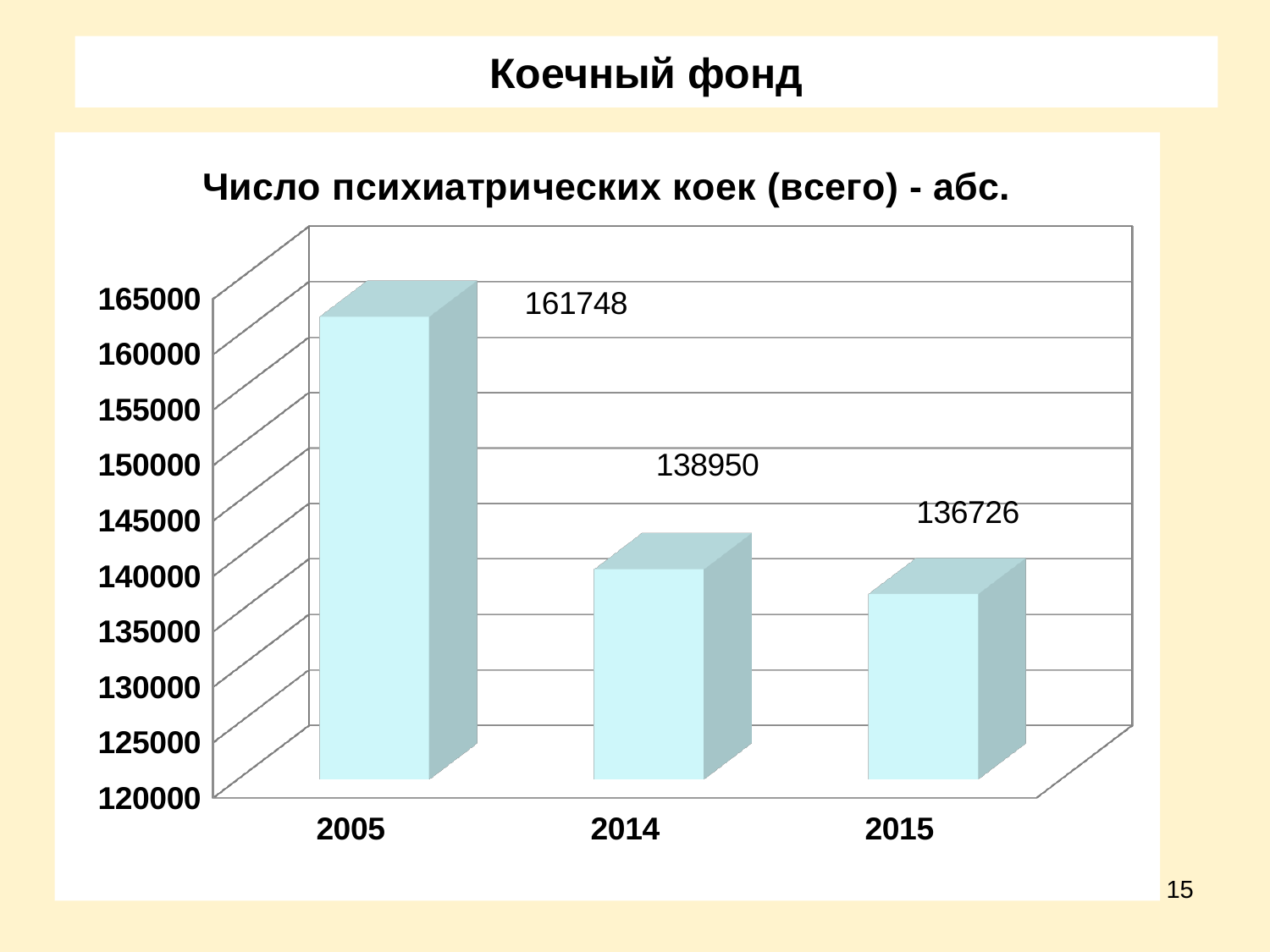
What kind of chart is shown on the slide? bar chart What is the value for 2014? 138950 What is the value for 2015? 136726 Which year has the highest value? 2005 What is the difference between the values for 2014 and 2015? 2224 What is the value for 2005? 161748 Do the values rise or fall from 2005 to 2015? fall Which year has the lowest value? 2015 How many years are shown on the x axis? 3 Is the value for 2005 greater or less than 160000? greater What is the difference between the values for 2005 and 2014? 22798 Which is larger, the value for 2014 or the value for 2015? 2014